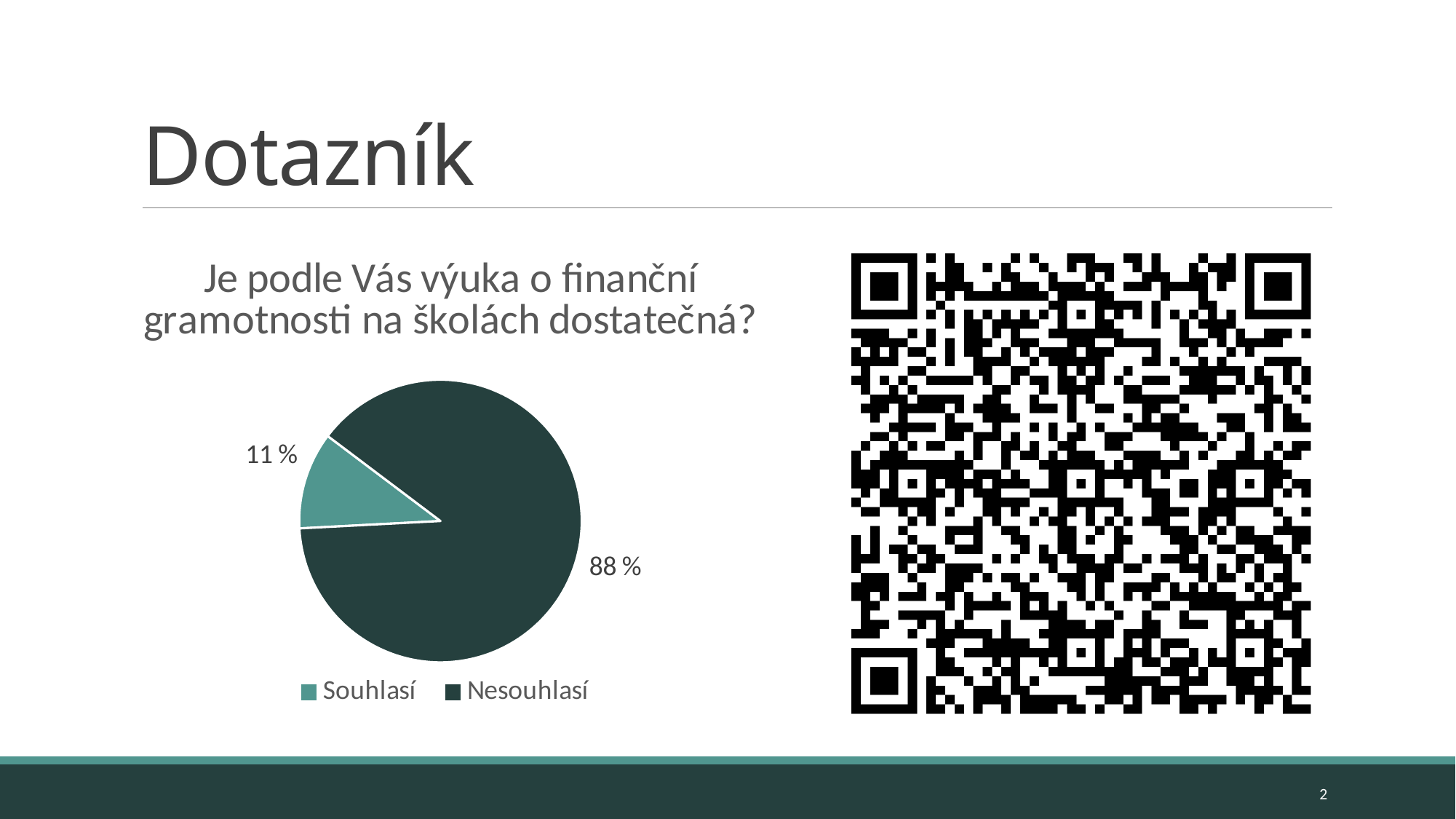
What is the difference between the Nesouhlasí and Souhlasí values? 77 % Which category has the smallest slice? Souhlasí Which legend entry is shown in the lighter teal colour? Souhlasí What kind of chart is shown on the slide? pie chart What is the title of the chart? Je podle Vás výuka o finanční gramotnosti na školách dostatečná? What is the value for Souhlasí? 11 % Which category has the largest slice? Nesouhlasí Which is larger, Souhlasí or Nesouhlasí? Nesouhlasí How many entries does the legend list? 2 How many slices does the pie chart have? 2 What is the value for Nesouhlasí? 88 %